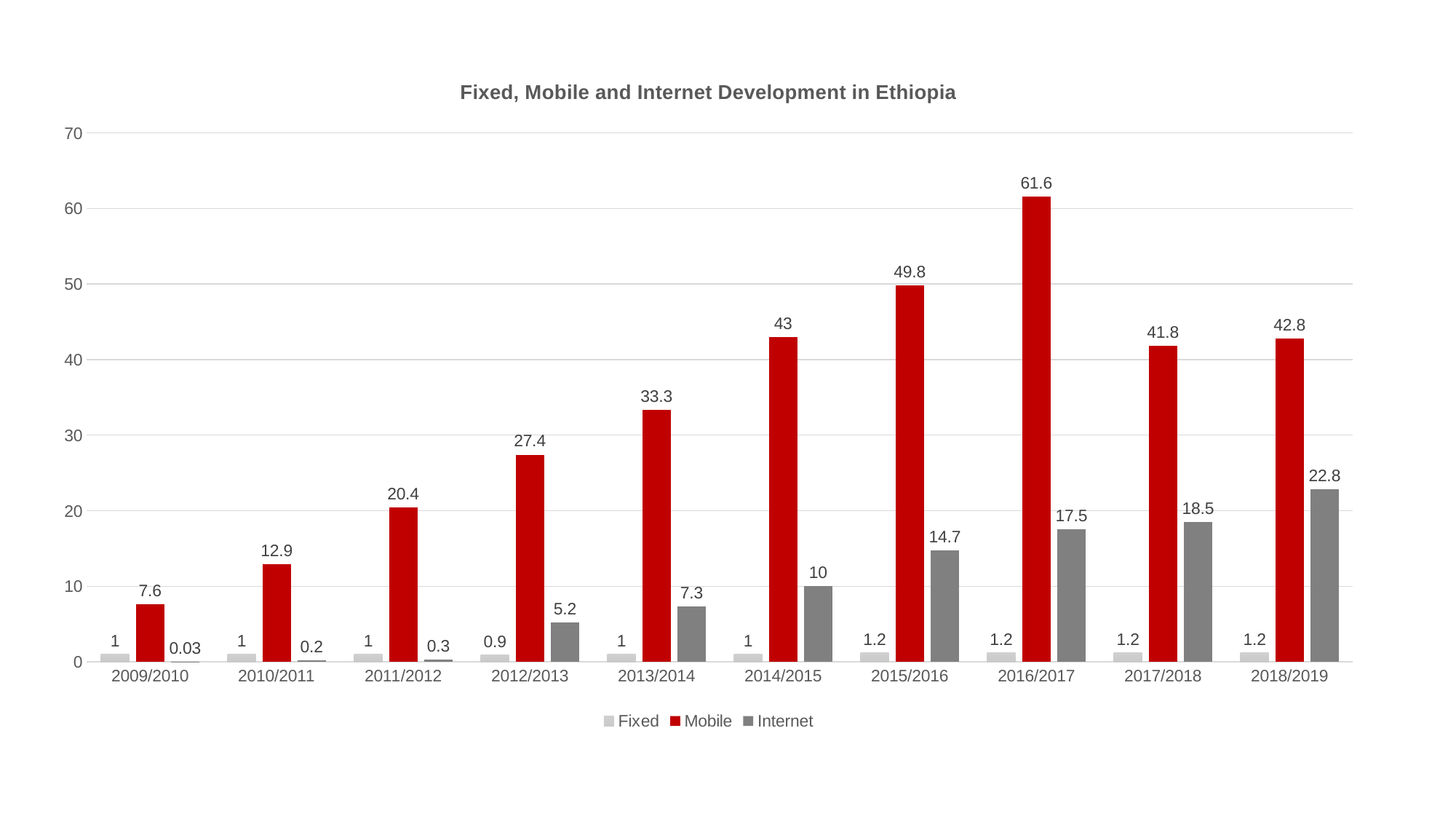
What kind of chart is shown? bar chart How many series does the legend list? 3 How many years are shown on the x axis? 10 In which year is the Mobile value highest? 2016/2017 What is the title of the chart? Fixed, Mobile and Internet Development in Ethiopia What is the Mobile value for 2016/2017? 61.6 What is the difference between the Mobile values for 2016/2017 and 2017/2018? 19.8 Is the Mobile value for 2015/2016 greater or less than 40? greater What is the Internet value for 2018/2019? 22.8 Which is larger, the Internet value for 2015/2016 or the Internet value for 2016/2017? 2016/2017 What is the Fixed value for 2012/2013? 0.9 In which year is the Internet value lowest? 2009/2010